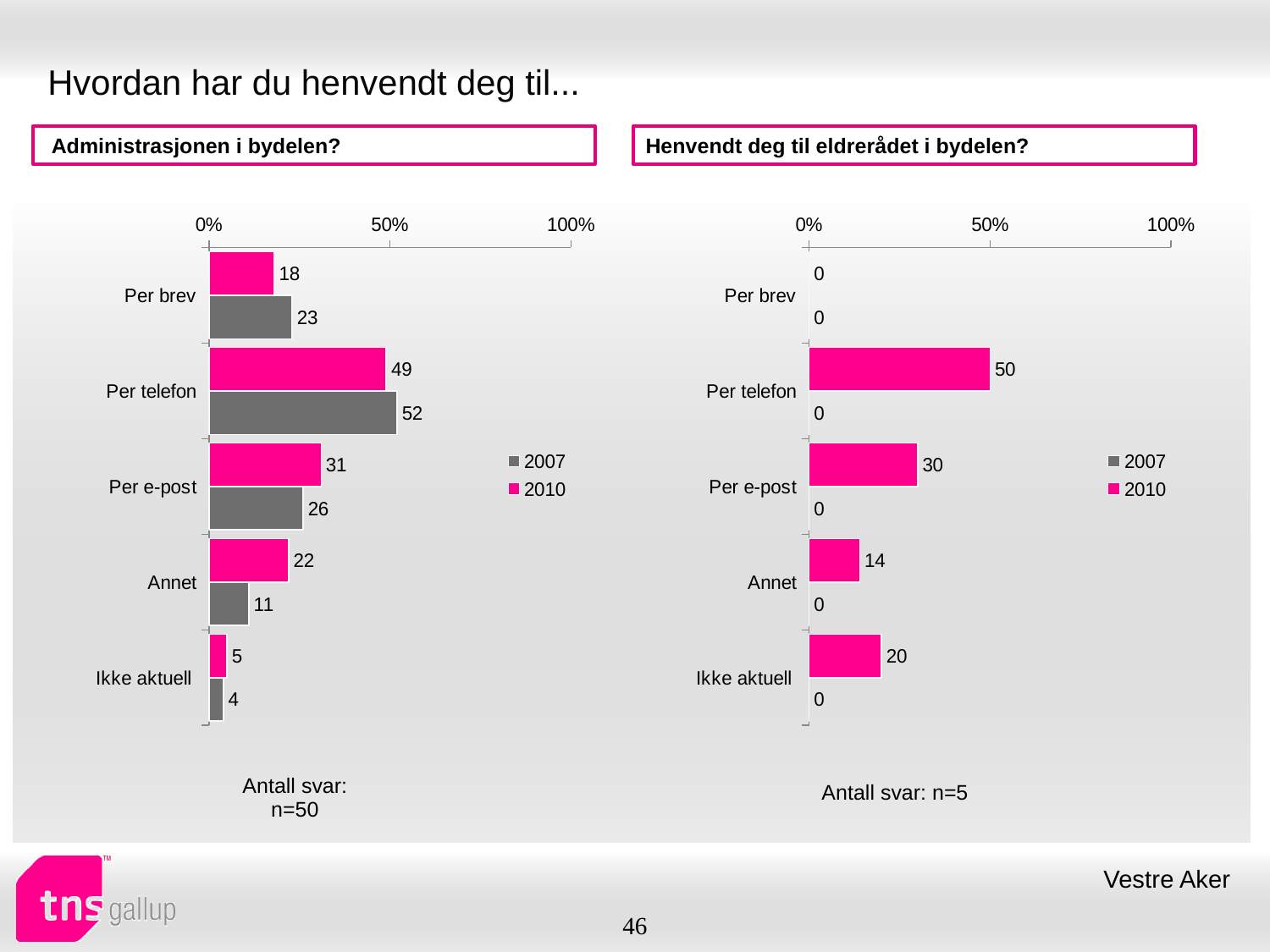
In the chart titled "Administrasjonen i bydelen?", which category has the highest value for 2007? Per telefon In the chart titled "Administrasjonen i bydelen?", which category has the lowest value for 2010? Ikke aktuell What kind of chart is the chart titled "Henvendt deg til eldrerådet i bydelen?"? Bar chart In the chart titled "Administrasjonen i bydelen?", what is the value for Per telefon in 2010? 49 In the chart titled "Henvendt deg til eldrerådet i bydelen?", what is the value for Per telefon in 2010? 50 In the chart titled "Administrasjonen i bydelen?", what is the value for Annet in 2007? 11 In the chart titled "Henvendt deg til eldrerådet i bydelen?", which category has the highest value for 2010? Per telefon In the chart titled "Administrasjonen i bydelen?", how many categories are shown on the vertical axis? 5 In the chart titled "Administrasjonen i bydelen?", which is larger for Per e-post: the 2007 value or the 2010 value? 2010 In the chart titled "Administrasjonen i bydelen?", what is the difference between the 2007 and 2010 values for Per brev? 5 In the chart titled "Henvendt deg til eldrerådet i bydelen?", what is the value for Ikke aktuell in 2010? 20 In the chart titled "Henvendt deg til eldrerådet i bydelen?", how many series does the legend list? 2